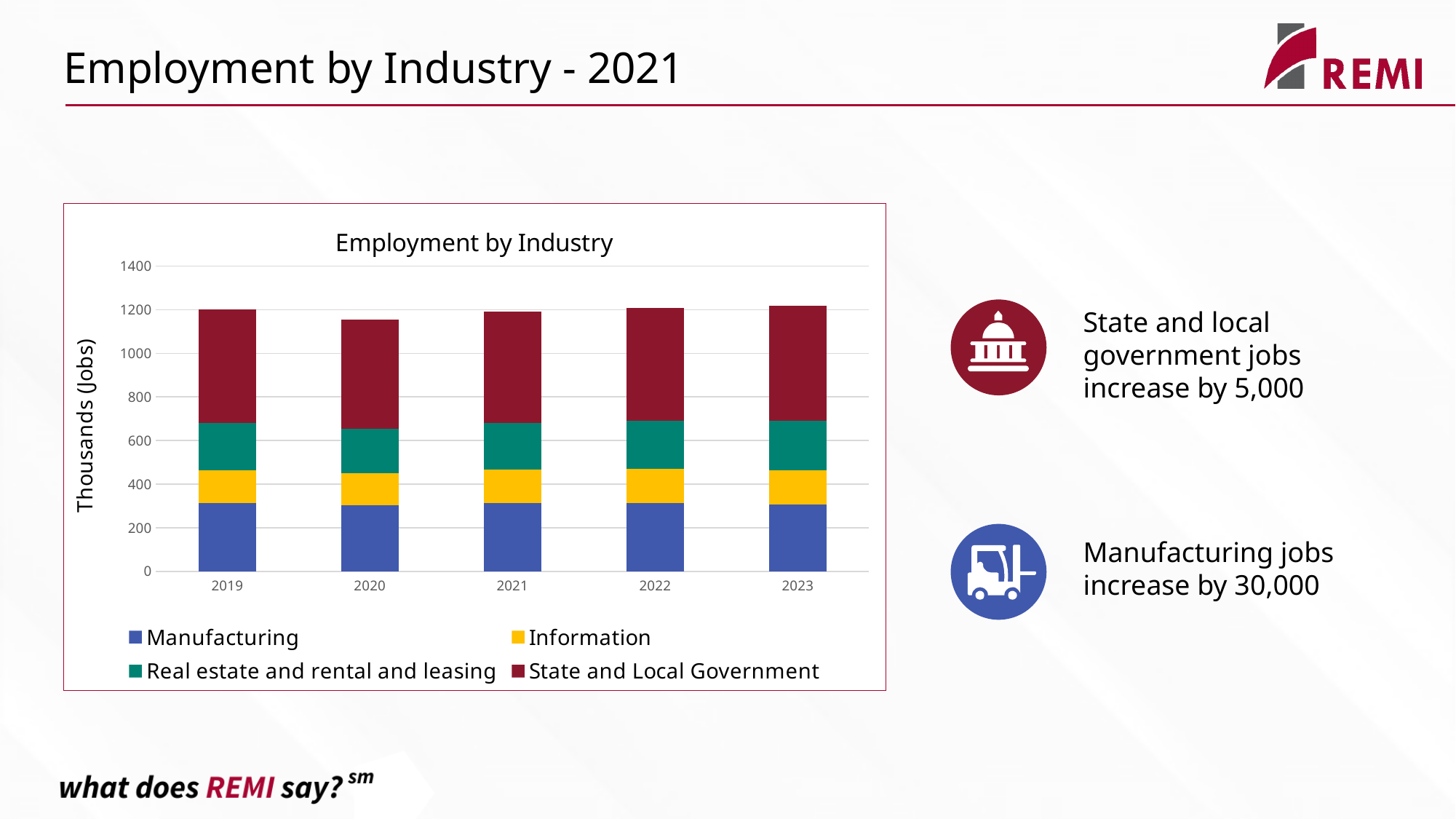
How many series does the chart legend list? 4 How many years are shown on the x axis of the chart? 5 Is the Manufacturing value for 2021 greater or less than 400? less Is the Manufacturing value for 2019 greater or less than 200? greater What is the label on the y axis of the chart? Thousands (Jobs) Which year has the lowest total stacked bar? 2020 Is the total stacked bar for 2019 greater or less than 1000? greater Which series is the largest segment in every stacked bar? State and Local Government What kind of chart is shown on the slide? stacked bar chart Which is larger, the total stacked bar for 2019 or for 2020? 2019 What is the title of the chart? Employment by Industry